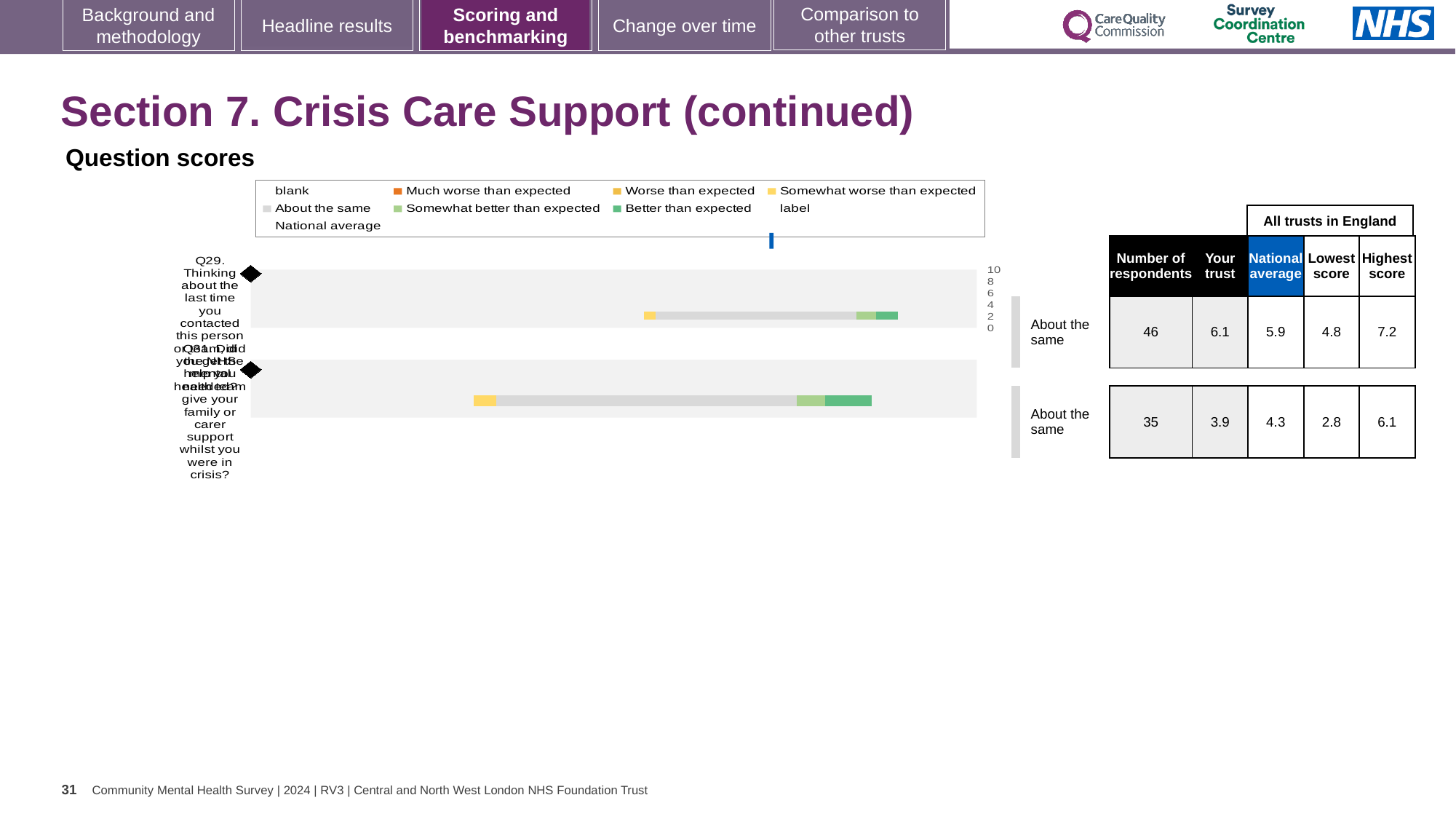
What is the 'Your trust' score for Q29? 6.1 Which question has the higher 'Your trust' score, Q29 or Q31? Q29 How many respondents answered Q31? 35 Which question has the higher 'Highest score' across all trusts in England? Q29 What benchmark category is shown for Q31? About the same By how much does the 'Your trust' score for Q29 exceed the national average? 0.2 What is the national average score for Q29? 5.9 What kind of chart is shown under 'Question scores'? bar chart How many questions are plotted in the chart? 2 What is the difference between the highest score and the lowest score for Q29? 2.4 What is the 'Your trust' score for Q31? 3.9